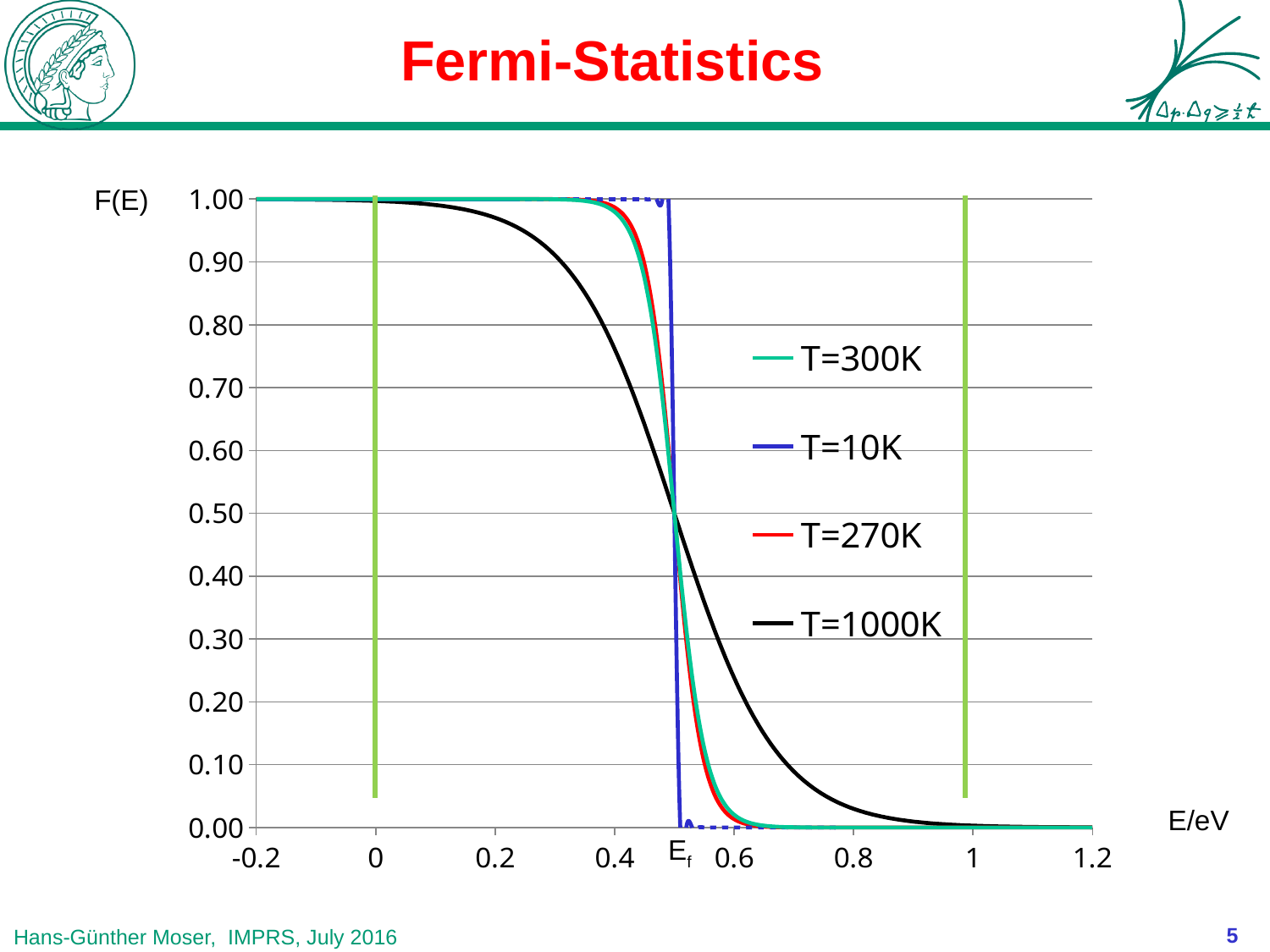
Is the value of F(E) for T=1000K at E = 0.2 eV greater or less than 0.90? greater What value of F(E) do all the curves cross at E_f? 0.50 Do the F(E) values rise or fall as E/eV increases along the x axis? fall At E = 0.4 eV, which series has the higher F(E): T=300K or T=1000K? T=300K At E = 0.6 eV, which series has the higher F(E): T=1000K or T=300K? T=1000K What colour is the line for T=1000K in the legend? black Is the value of F(E) for T=300K at E = 0.4 eV greater or less than 0.90? greater Is the value of F(E) for T=1000K at E = 0.8 eV greater or less than 0.10? less What is the label on the x axis of the chart? E/eV How many series does the legend list? 4 What kind of chart is shown on the slide? line chart